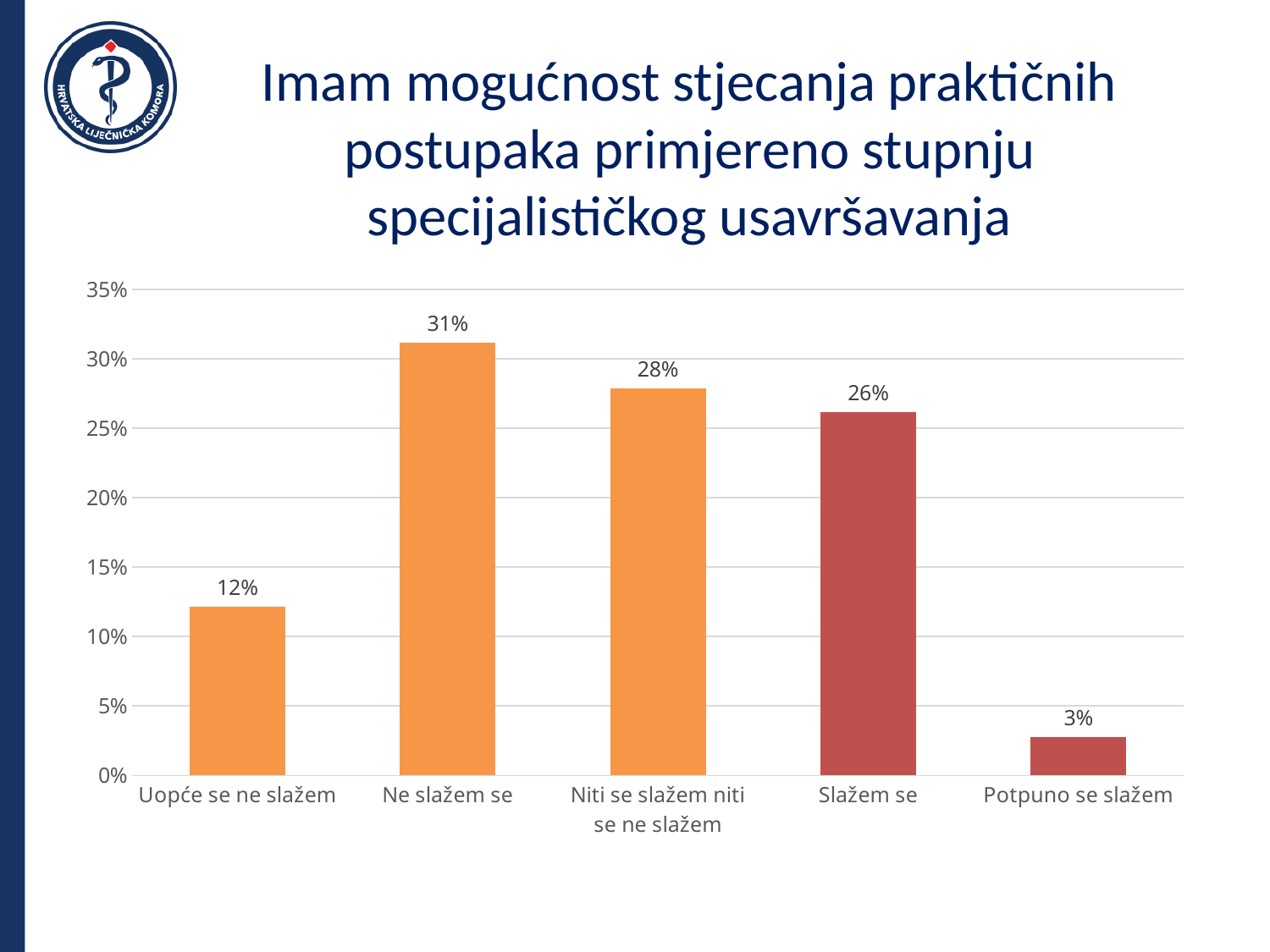
Which category has the highest value? Ne slažem se Is the value for "Slažem se" greater or less than 20%? greater What is the value for "Potpuno se slažem"? 3% What is the combined value of "Slažem se" and "Potpuno se slažem"? 29% Which is larger, the value for "Niti se slažem niti se ne slažem" or the value for "Uopće se ne slažem"? Niti se slažem niti se ne slažem What is the value for "Ne slažem se"? 31% What kind of chart is shown on the slide? bar chart How many categories are shown on the x axis? 5 What colour are the bars for "Slažem se" and "Potpuno se slažem"? red What is the difference between the values for "Ne slažem se" and "Slažem se"? 5% Which category has the lowest value? Potpuno se slažem What is the value for "Uopće se ne slažem"? 12%